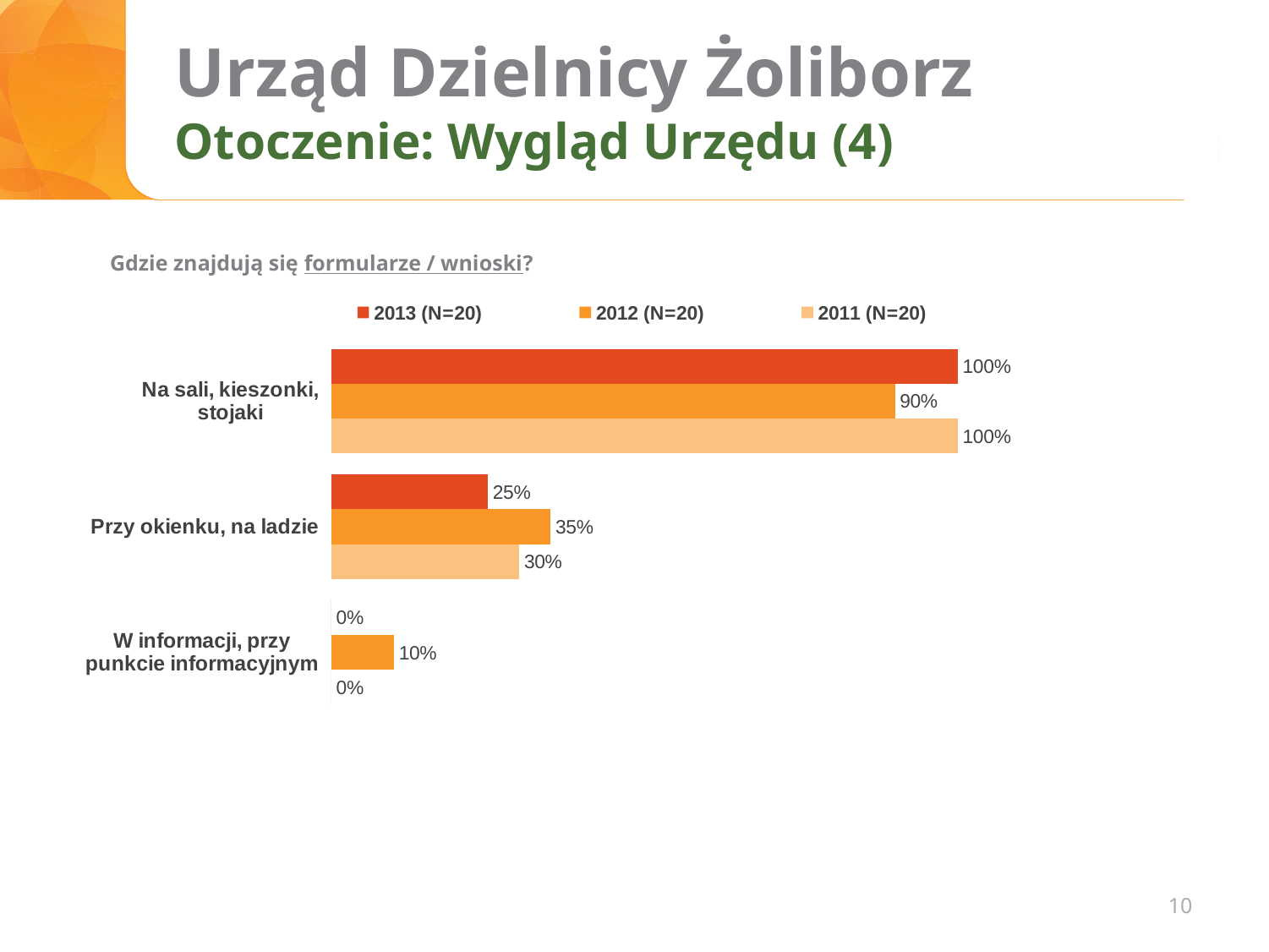
For "Przy okienku, na ladzie", which series has the larger value: 2011 (N=20) or 2013 (N=20)? 2011 (N=20) What is the value for "Na sali, kieszonki, stojaki" in the 2012 (N=20) series? 90% What is the value for "Przy okienku, na ladzie" in the 2012 (N=20) series? 35% How many categories are shown on the chart? 3 What is the value for "Na sali, kieszonki, stojaki" in the 2013 (N=20) series? 100% Which category has the lowest value in the 2012 (N=20) series? W informacji, przy punkcie informacyjnym What is the difference between the 2012 (N=20) and 2013 (N=20) values for "Przy okienku, na ladzie"? 10% Which category has the highest value in the 2013 (N=20) series? Na sali, kieszonki, stojaki How many series does the legend list? 3 What kind of chart is shown on the slide? Bar chart What is the value for "W informacji, przy punkcie informacyjnym" in the 2011 (N=20) series? 0% What question does the chart answer, as stated above it? Gdzie znajdują się formularze / wnioski?